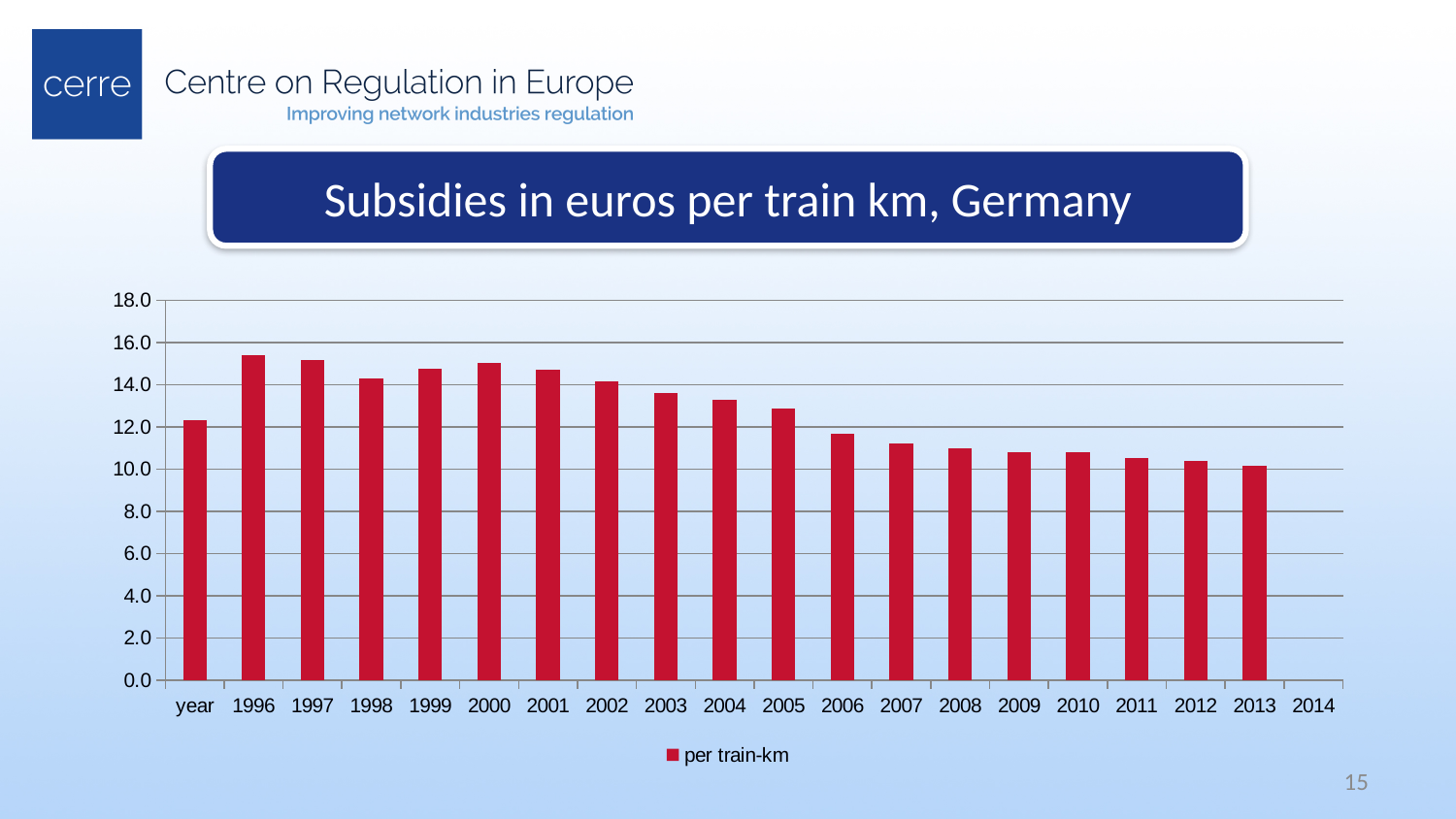
What kind of chart is shown on the slide? bar chart Do the values generally rise or fall from 1996 to 2013? fall Is the value for 2000 greater or less than 14.0? greater Is the value for 2009 greater or less than 10.0? greater How many series does the legend list? 1 Is the value for 2013 greater or less than 12.0? less What is the title of the chart? Subsidies in euros per train km, Germany Which is larger, the value for 1996 or the value for 2013? 1996 Which is larger, the value for 2003 or the value for 2008? 2003 What is the legend entry for the series? per train-km